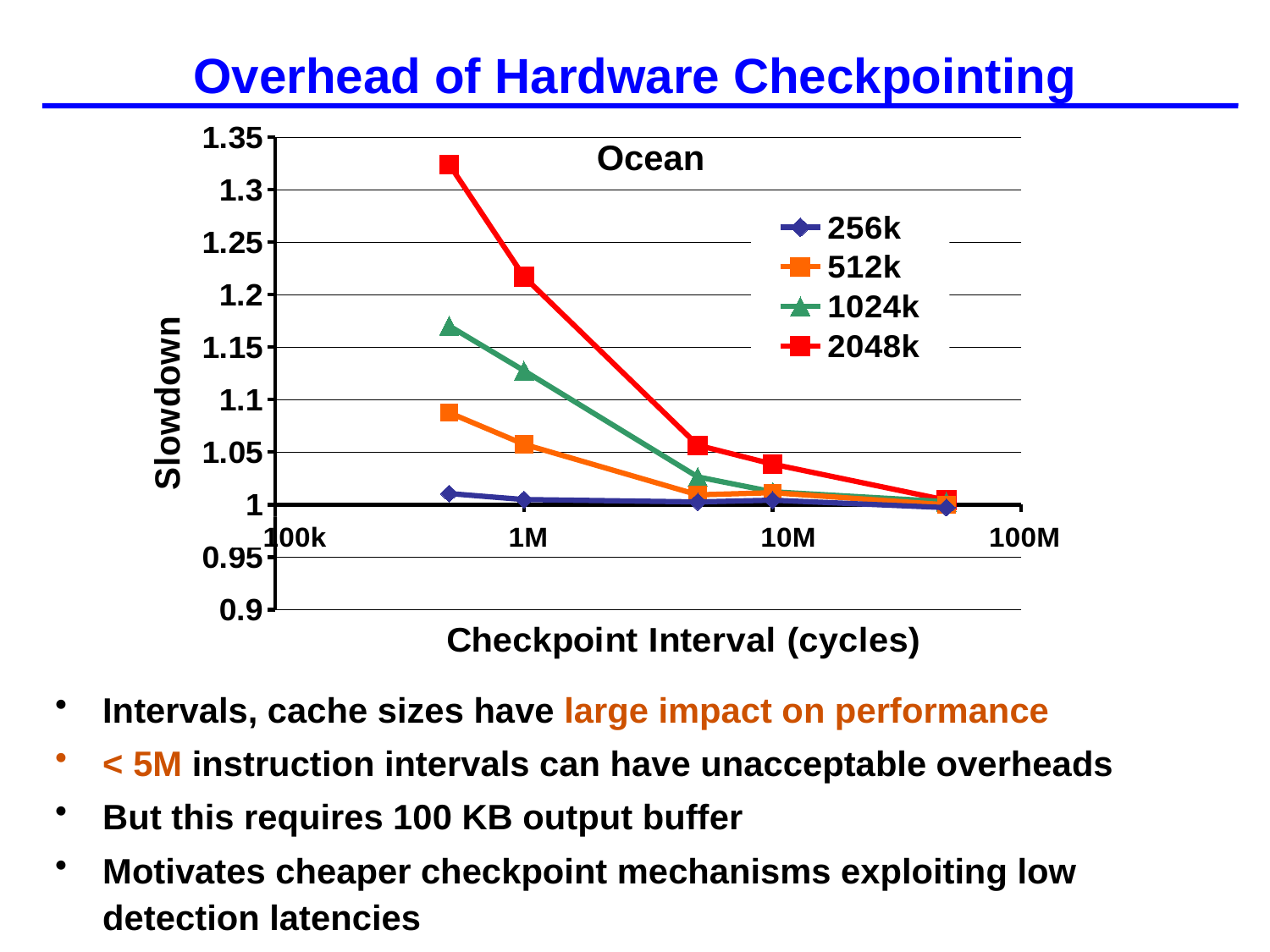
What is the label of the y axis? Slowdown What is the title shown inside the chart? Ocean Which series has the lowest slowdown at the leftmost plotted checkpoint interval? 256k How many data points are plotted for the 2048k series? 5 Is the slowdown for the 2048k series at its leftmost point greater or less than 1.3? greater At the leftmost plotted checkpoint interval, which series has the larger slowdown, 512k or 1024k? 1024k Does the slowdown for the 2048k series rise or fall as the checkpoint interval increases? fall Which series has the highest slowdown at the leftmost plotted checkpoint interval? 2048k Is the slowdown for the 256k series at its leftmost point greater or less than 1.05? less Is the slowdown for the 1024k series at its leftmost point greater or less than 1.2? less How many series does the legend list? 4 What kind of chart is shown on the slide? line chart